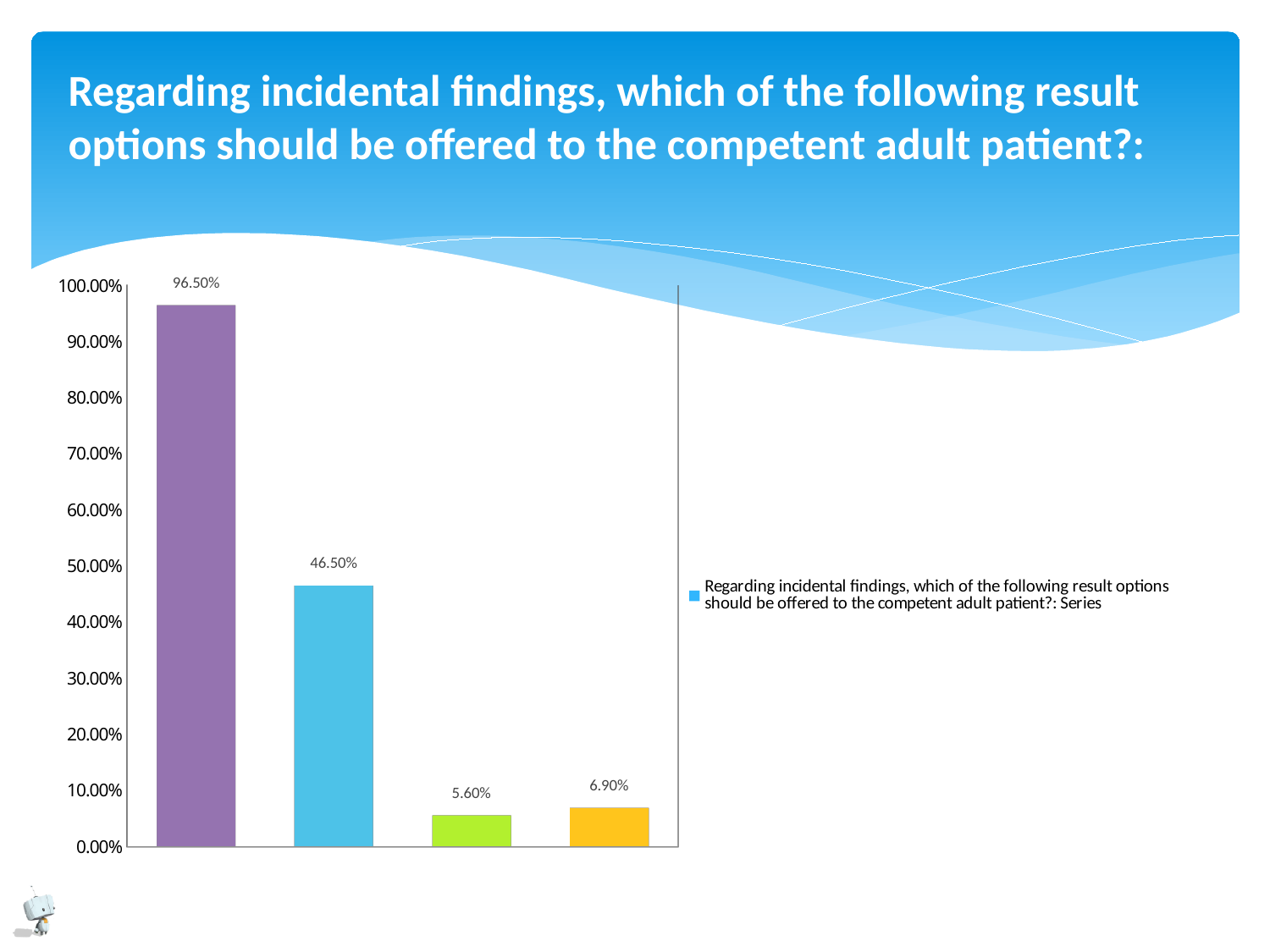
What type of chart is shown on the slide? bar chart What is the value shown on the fourth (yellow) bar from the left? 6.90% How many bars are plotted in the chart? 4 Is the value of the second (blue) bar greater or less than 50.00%? less What is the value shown on the second (blue) bar from the left? 46.50% What is the value shown on the third (green) bar from the left? 5.60% Which is larger, the third (green) bar or the fourth (yellow) bar? the fourth (yellow) bar What is the difference between the first (purple) bar and the second (blue) bar? 50.00% What is the value shown on the first (purple) bar from the left? 96.50% Which bar has the lowest value? the third (green) bar, 5.60% Which bar has the highest value? the first (purple) bar, 96.50% How many series does the legend list? 1